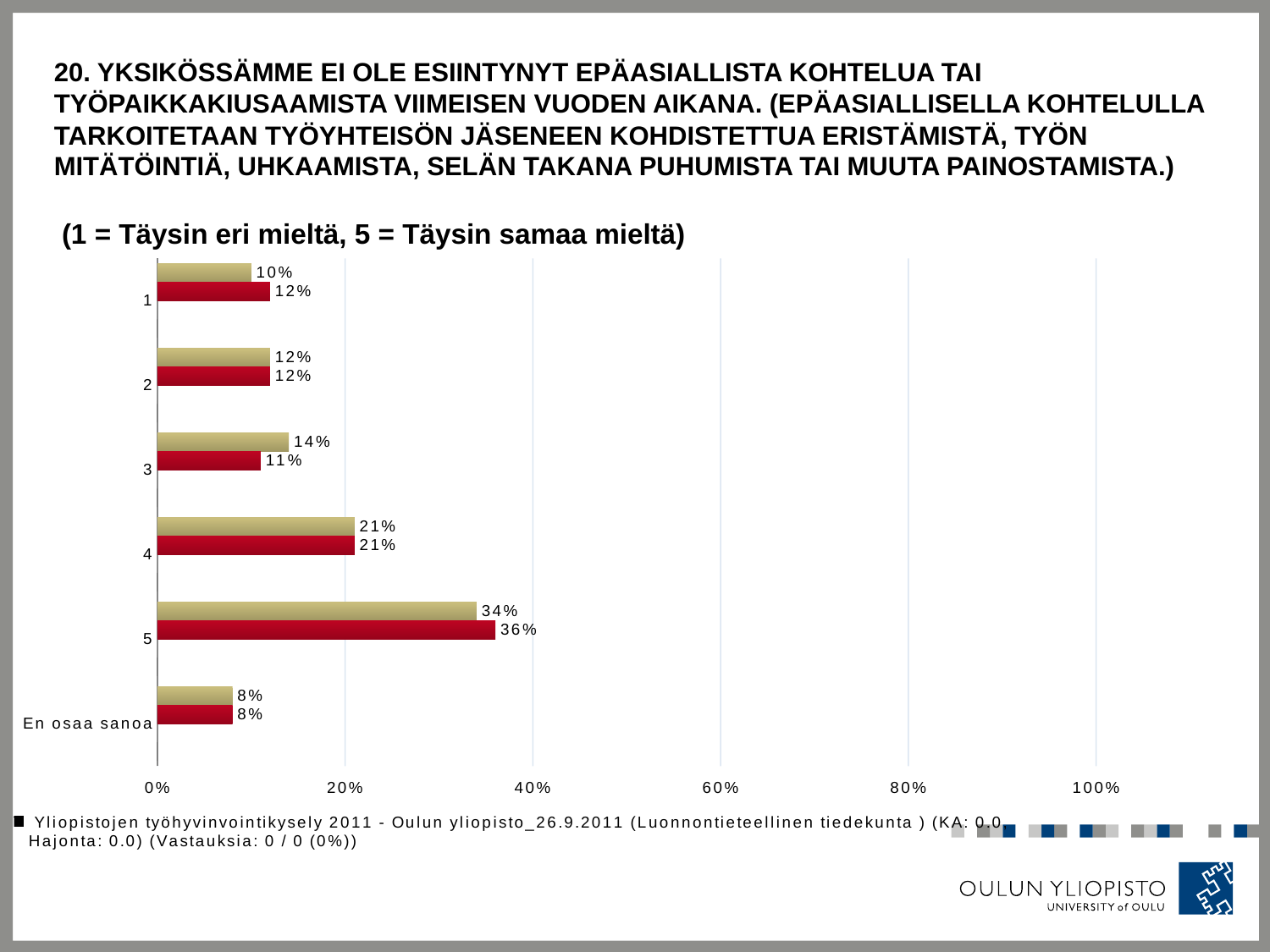
What is the maximum value shown on the horizontal axis of the chart? 100% Is the red bar value for category 5 greater or less than 40%? less What is the value of the red bar for 'En osaa sanoa'? 8% Which category has the lowest tan (upper) bar value? En osaa sanoa What is the value of the tan (upper) bar for category 3? 14% What type of chart is shown on the slide? Bar chart For category 5, how much larger is the red bar than the tan bar? 2 percentage points What is the value of the red bar for category 5? 36% What is the value of the tan (upper) bar for category 1? 10% Which category has the highest red bar value? 5 For category 3, which bar is larger, the tan bar or the red bar? The tan bar (14% vs 11%) How many categories are shown on the vertical axis of the chart? 6